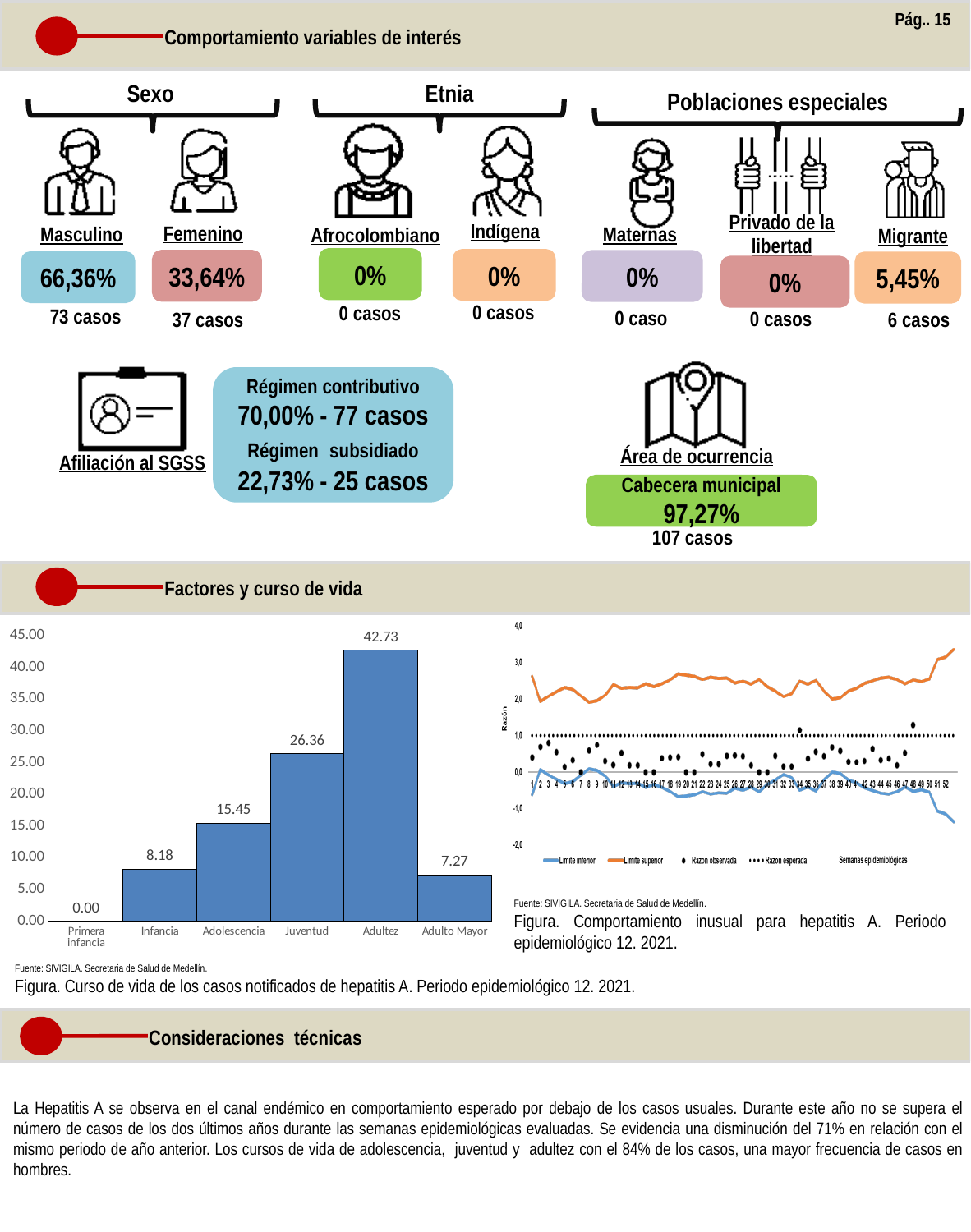
In the bar chart 'Curso de vida de los casos notificados de hepatitis A', what is the value for Infancia? 8.18 What kind of chart is the 'Curso de vida de los casos notificados de hepatitis A' figure? Bar chart In the bar chart 'Curso de vida de los casos notificados de hepatitis A', which is larger, Adolescencia or Adulto Mayor? Adolescencia In the bar chart 'Curso de vida de los casos notificados de hepatitis A', which category has the lowest value? Primera infancia In the bar chart 'Curso de vida de los casos notificados de hepatitis A', what is the value for Adultez? 42.73 In the bar chart 'Curso de vida de los casos notificados de hepatitis A', is the value for Juventud greater or less than 25.00? greater In the chart 'Comportamiento inusual para hepatitis A', what is the label of the y axis? Razón In the bar chart 'Curso de vida de los casos notificados de hepatitis A', what is the difference between the values for Adultez and Juventud? 16.37 What kind of chart is the 'Comportamiento inusual para hepatitis A' figure? Line chart In the bar chart 'Curso de vida de los casos notificados de hepatitis A', which category has the highest value? Adultez In the bar chart 'Curso de vida de los casos notificados de hepatitis A', how many categories are shown on the x axis? 6 In the bar chart 'Curso de vida de los casos notificados de hepatitis A', what is the value for Adulto Mayor? 7.27